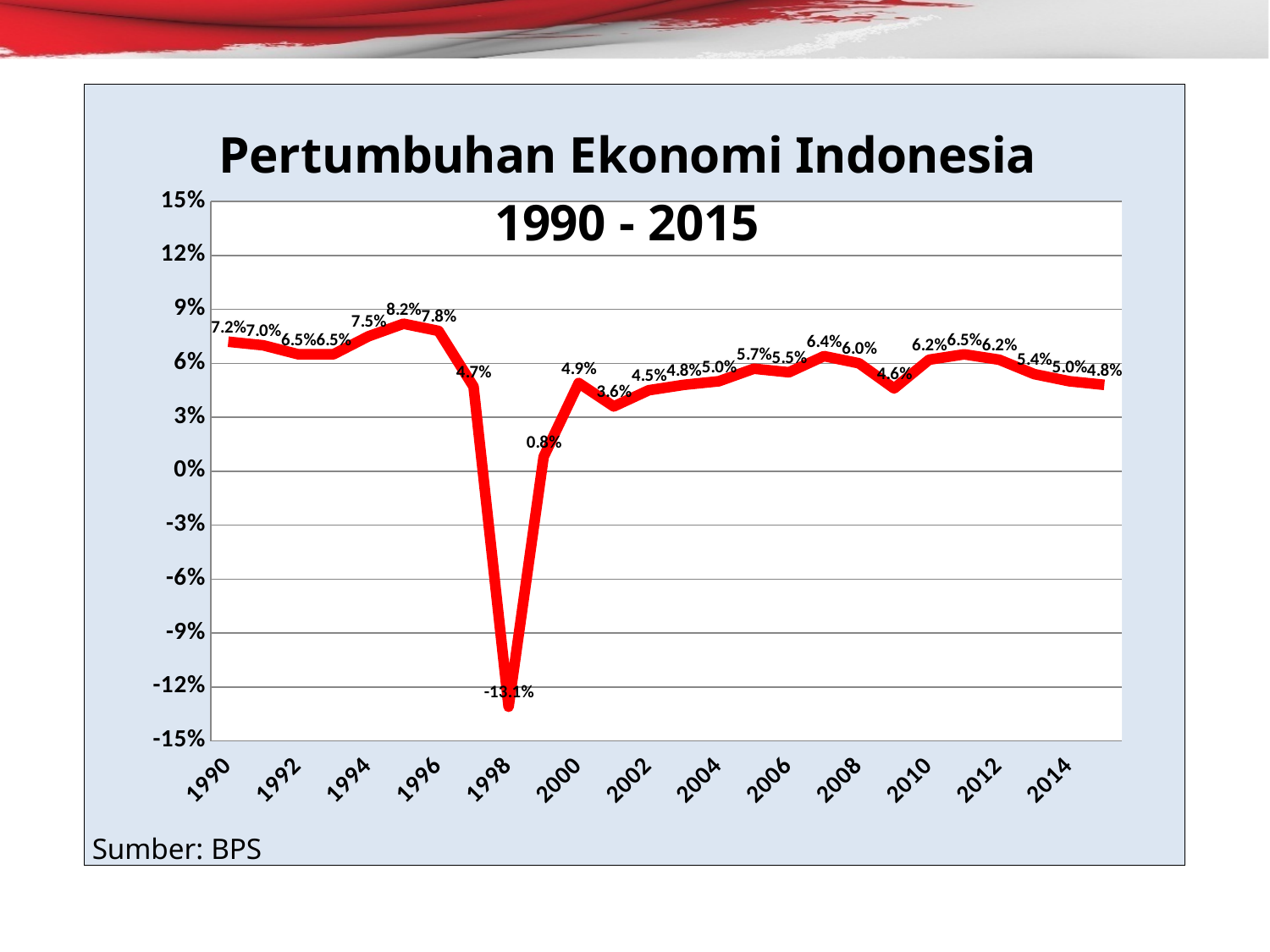
Does the line rise or fall from 1996 to 1998? fall What type of chart is shown on the slide? line chart What is the economic growth value for 1990? 7.2% What is the economic growth value for 1998? -13.1% What is the highest economic growth value shown on the chart? 8.2% What is the economic growth value for 2008? 6.0% What is the economic growth value for 2014? 5.0% Which year has the lowest economic growth value? 1998 Which year has the larger value, 1996 or 2012? 1996 What is the title of the chart? Pertumbuhan Ekonomi Indonesia 1990 - 2015 Is the value for 2002 greater or less than 6%? less What is the difference between the values for 1990 and 2000? 2.3%